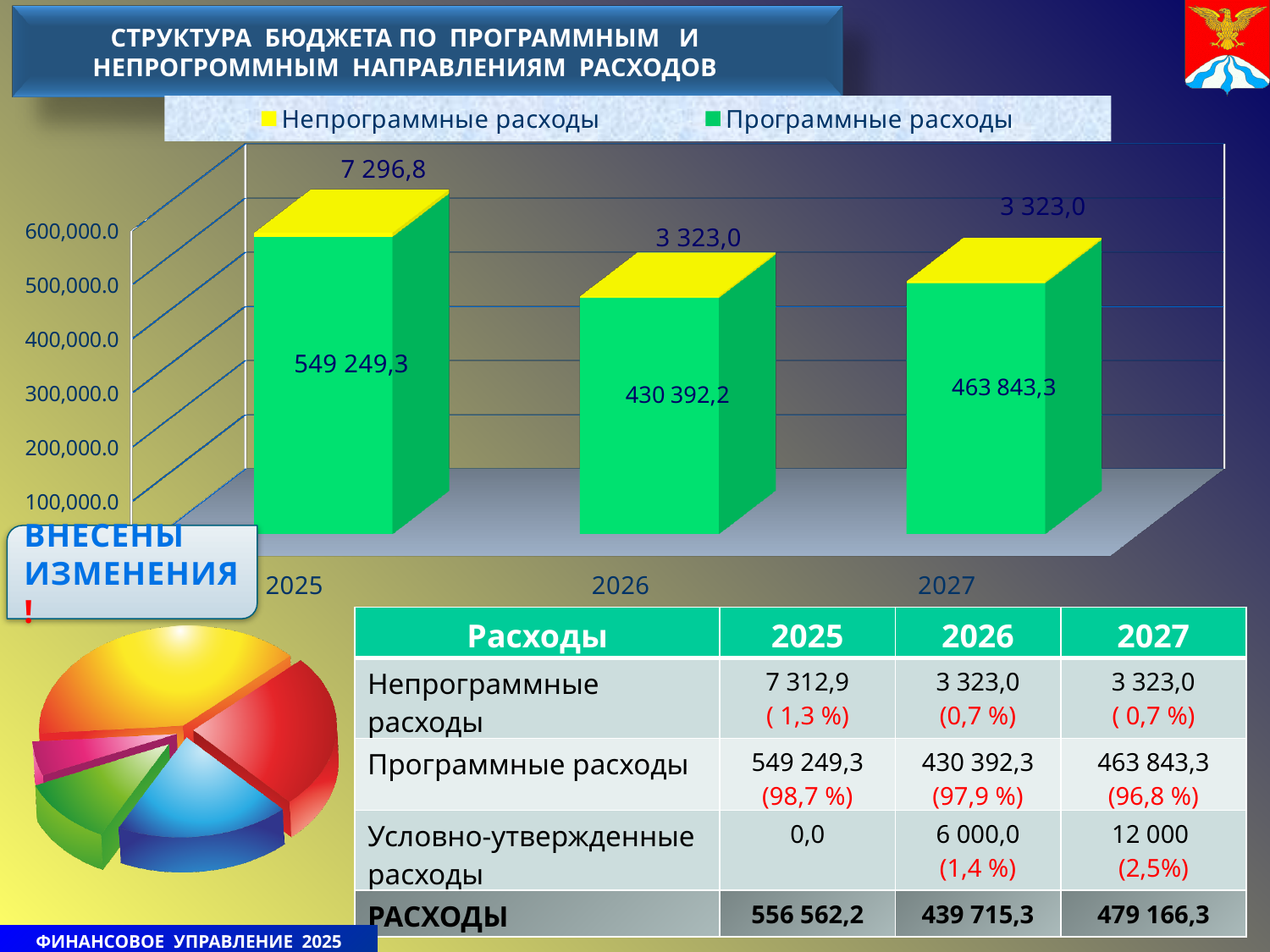
What is the total of the stacked bar for 2026? 433 715,2 What is the difference between Программные расходы in 2025 and 2026? 118 857,1 Which is larger: Программные расходы in 2027 or in 2026? 2027 Which year has the highest value of Программные расходы? 2025 How many years are shown on the x axis of the bar chart? 3 What is the value of Программные расходы for 2026? 430 392,2 Is the value of Программные расходы for 2026 greater or less than 400,000.0? greater How many series does the legend of the bar chart list? 2 What is the value of Непрограммные расходы for 2027? 3 323,0 Which year has the lowest value of Программные расходы? 2026 What is the value of Непрограммные расходы for 2025? 7 296,8 What is the value of Программные расходы for 2025? 549 249,3